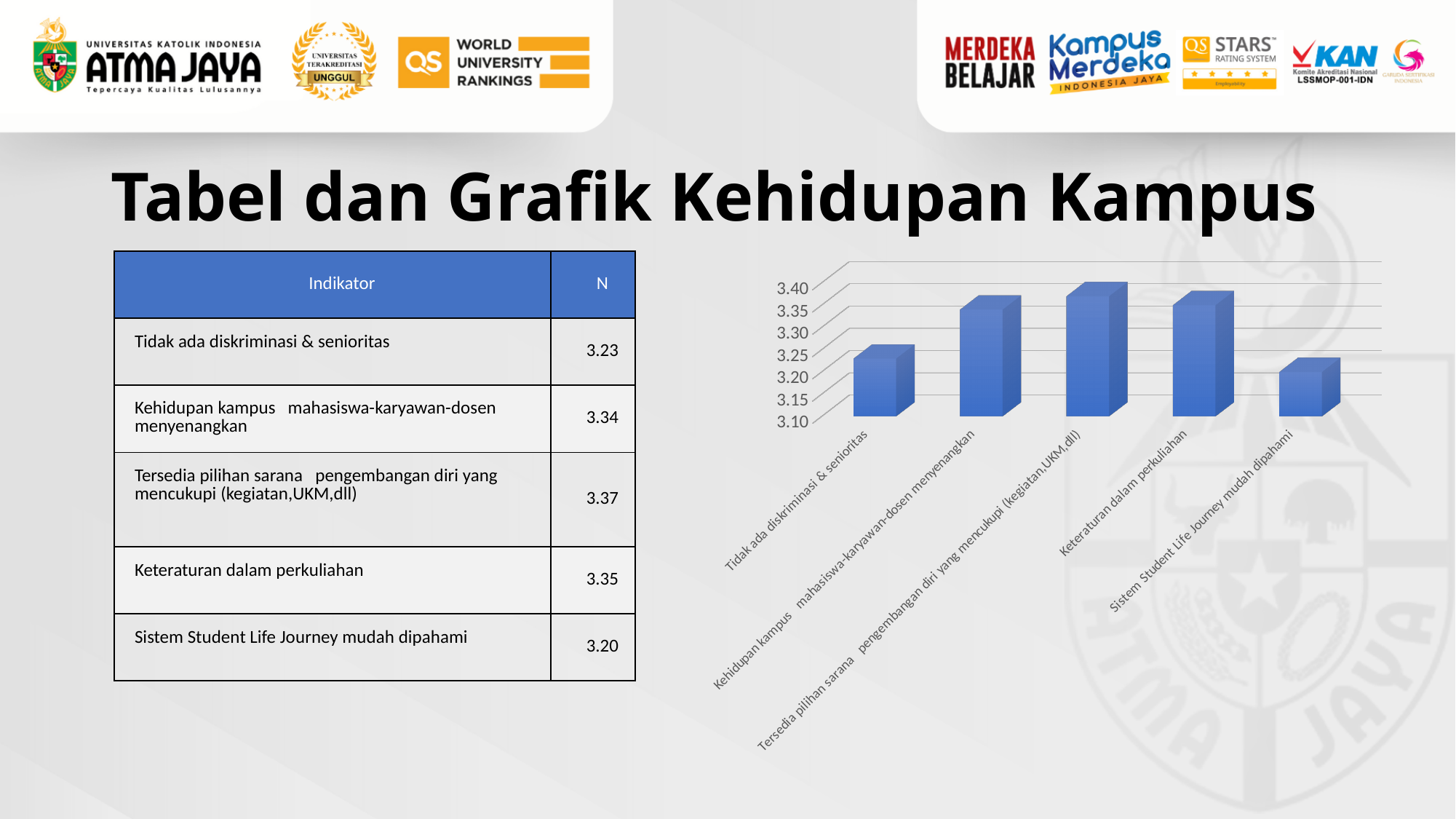
What is the title of the slide containing the chart? Tabel dan Grafik Kehidupan Kampus What is the value for 'Tidak ada diskriminasi & senioritas'? 3.23 What type of chart is shown on the slide? bar chart What is the value for 'Sistem Student Life Journey mudah dipahami'? 3.20 Which is larger: the value for 'Kehidupan kampus mahasiswa-karyawan-dosen menyenangkan' or for 'Tidak ada diskriminasi & senioritas'? Kehidupan kampus mahasiswa-karyawan-dosen menyenangkan Which indicator has the lowest value? Sistem Student Life Journey mudah dipahami Is the value for 'Sistem Student Life Journey mudah dipahami' greater or less than 3.25? less What is the difference between the values for 'Tersedia pilihan sarana pengembangan diri yang mencukupi (kegiatan,UKM,dll)' and 'Sistem Student Life Journey mudah dipahami'? 0.17 Which indicator has the highest value? Tersedia pilihan sarana pengembangan diri yang mencukupi (kegiatan,UKM,dll) What is the value for 'Keteraturan dalam perkuliahan'? 3.35 How many categories (indicators) are plotted in the bar chart? 5 Is the value for 'Kehidupan kampus mahasiswa-karyawan-dosen menyenangkan' greater or less than 3.30? greater